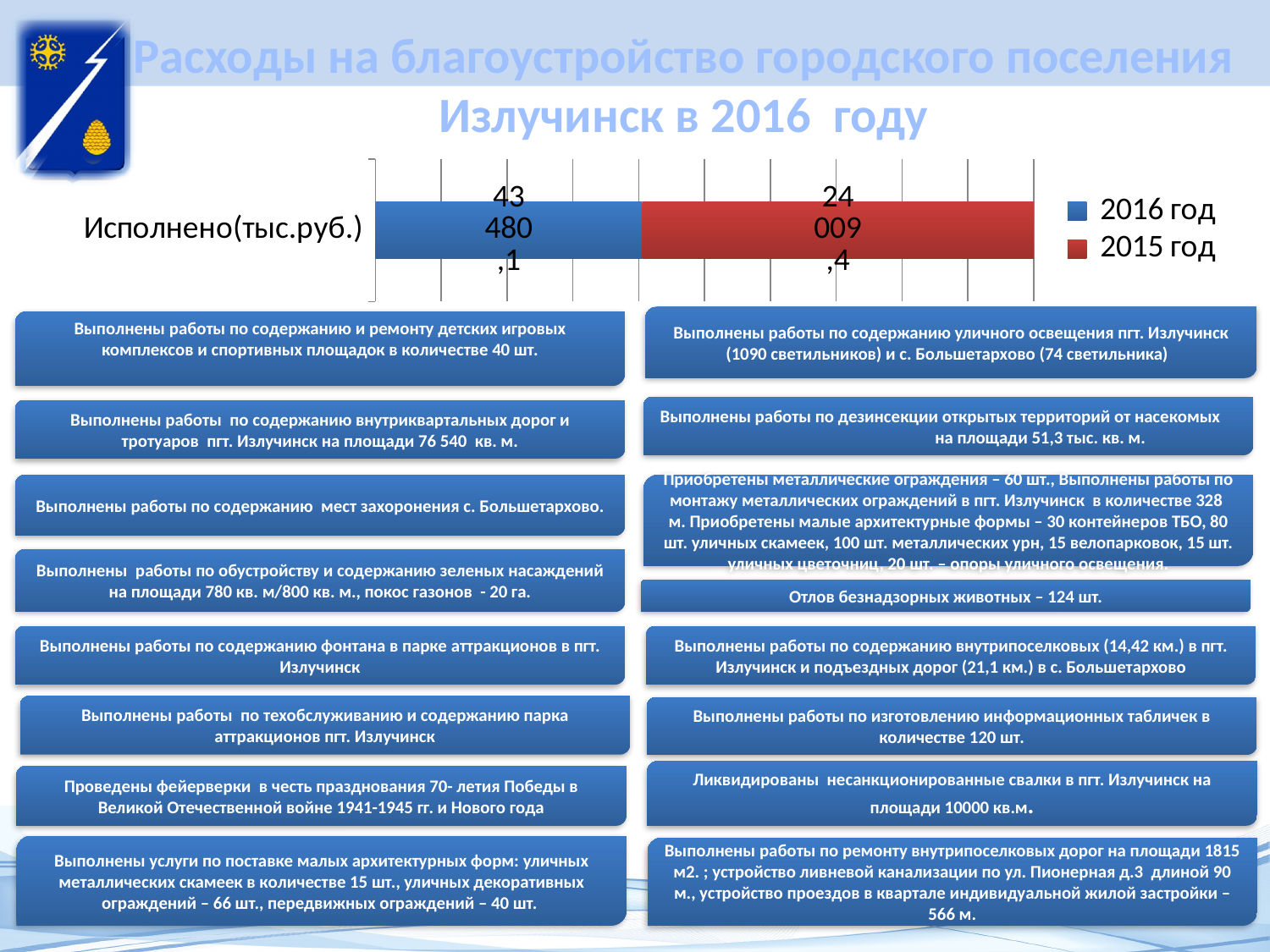
How many series does the chart legend list? 2 How many categories are plotted on the chart's axis? 1 What is the total of the stacked bar for Исполнено(тыс.руб.)? 67 489,5 What is the value for 2015 год in the chart? 24 009,4 What kind of chart is shown on the slide? bar chart What is the label of the category on the chart's axis? Исполнено(тыс.руб.) What is the value for 2016 год in the chart? 43 480,1 What is the difference between the 2016 год and 2015 год values? 19 470,7 What colour represents 2015 год in the chart? red